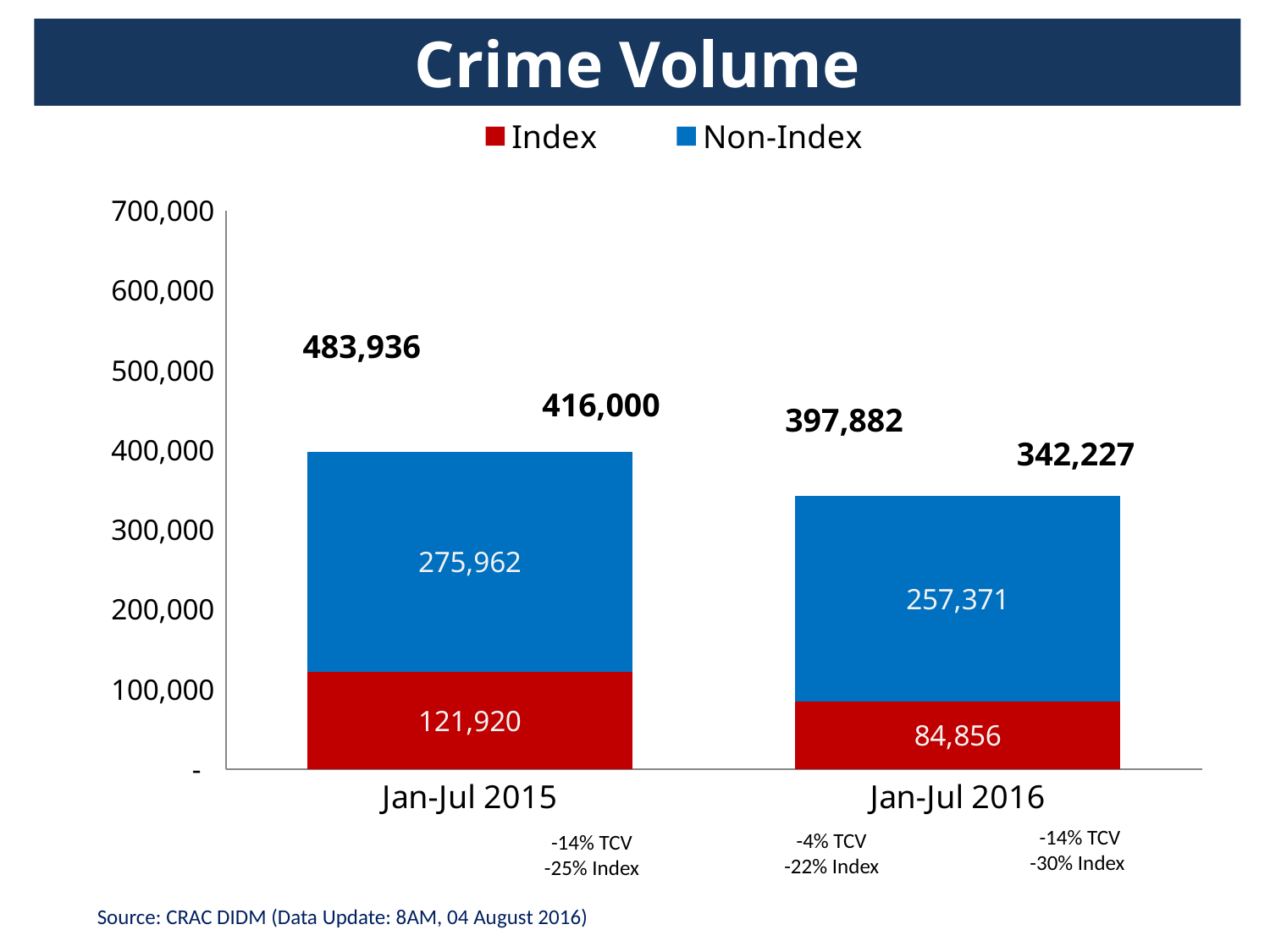
What is the Non-Index value for Jan-Jul 2015? 275,962 What is the difference between the Index values for Jan-Jul 2015 and Jan-Jul 2016? 37,064 Which period has the higher Index value, Jan-Jul 2015 or Jan-Jul 2016? Jan-Jul 2015 What is the total of the stacked bar for Jan-Jul 2016 (Index plus Non-Index)? 342,227 How many series does the legend list? 2 What kind of chart is shown on the slide? Stacked bar chart What is the Index value for Jan-Jul 2016? 84,856 Which colour represents the Index series in the chart? Red What is the Index value for Jan-Jul 2015? 121,920 What is the Non-Index value for Jan-Jul 2016? 257,371 What is the difference between the Non-Index values for Jan-Jul 2015 and Jan-Jul 2016? 18,591 What is the total of the stacked bar for Jan-Jul 2015 (Index plus Non-Index)? 397,882